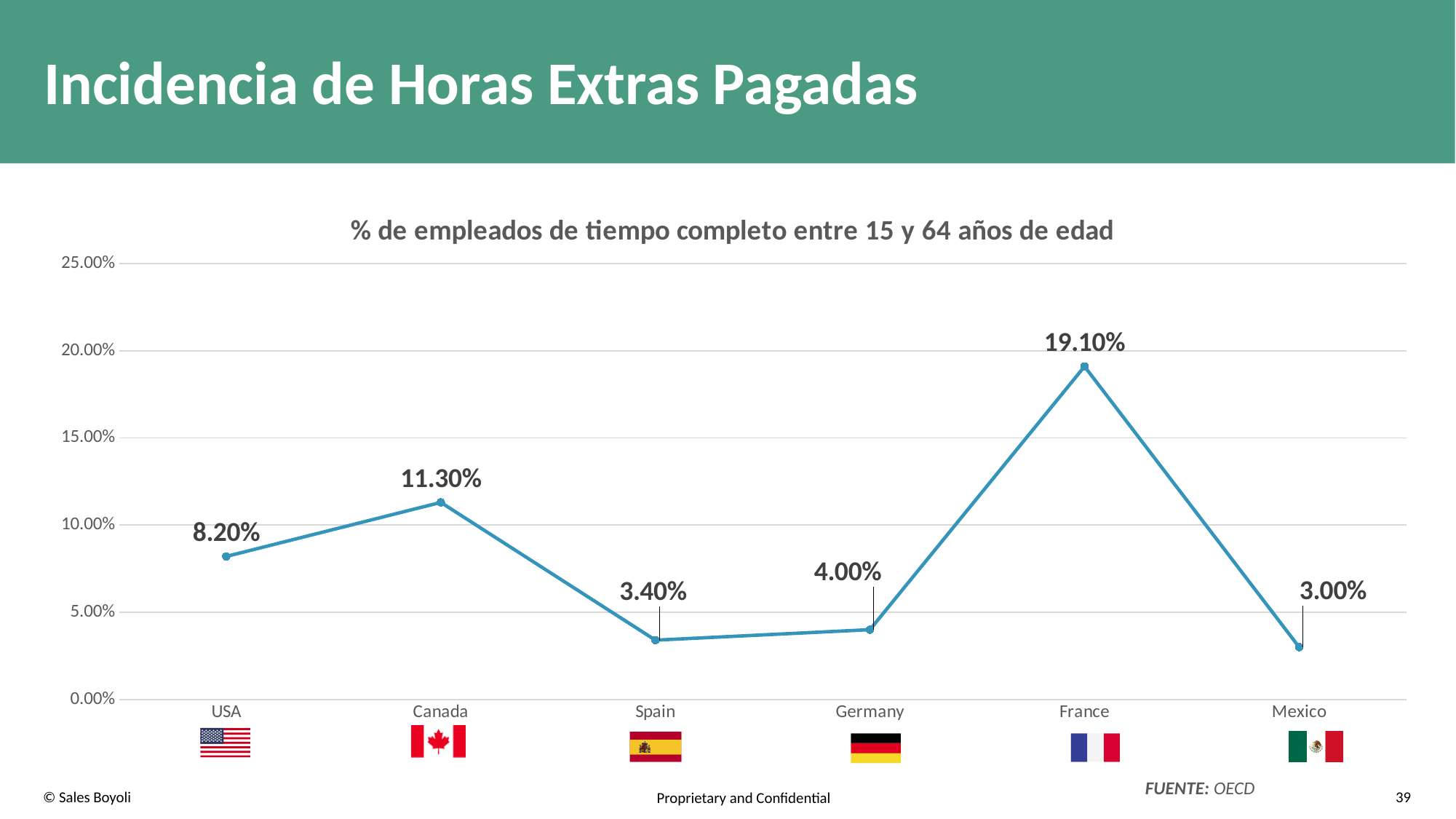
What is the value for Canada? 11.30% What is the title of the chart? % de empleados de tiempo completo entre 15 y 64 años de edad What is the value for Mexico? 3.00% How many countries are plotted on the chart? 6 What kind of chart is shown on the slide? line chart Which is larger, the value for Germany or the value for Spain? Germany What is the difference between the values for France and Canada? 7.80% What is the value for France? 19.10% Which country has the highest value? France Is the value for USA greater or less than 10.00%? less What is the difference between the values for USA and Spain? 4.80% Which country has the lowest value? Mexico